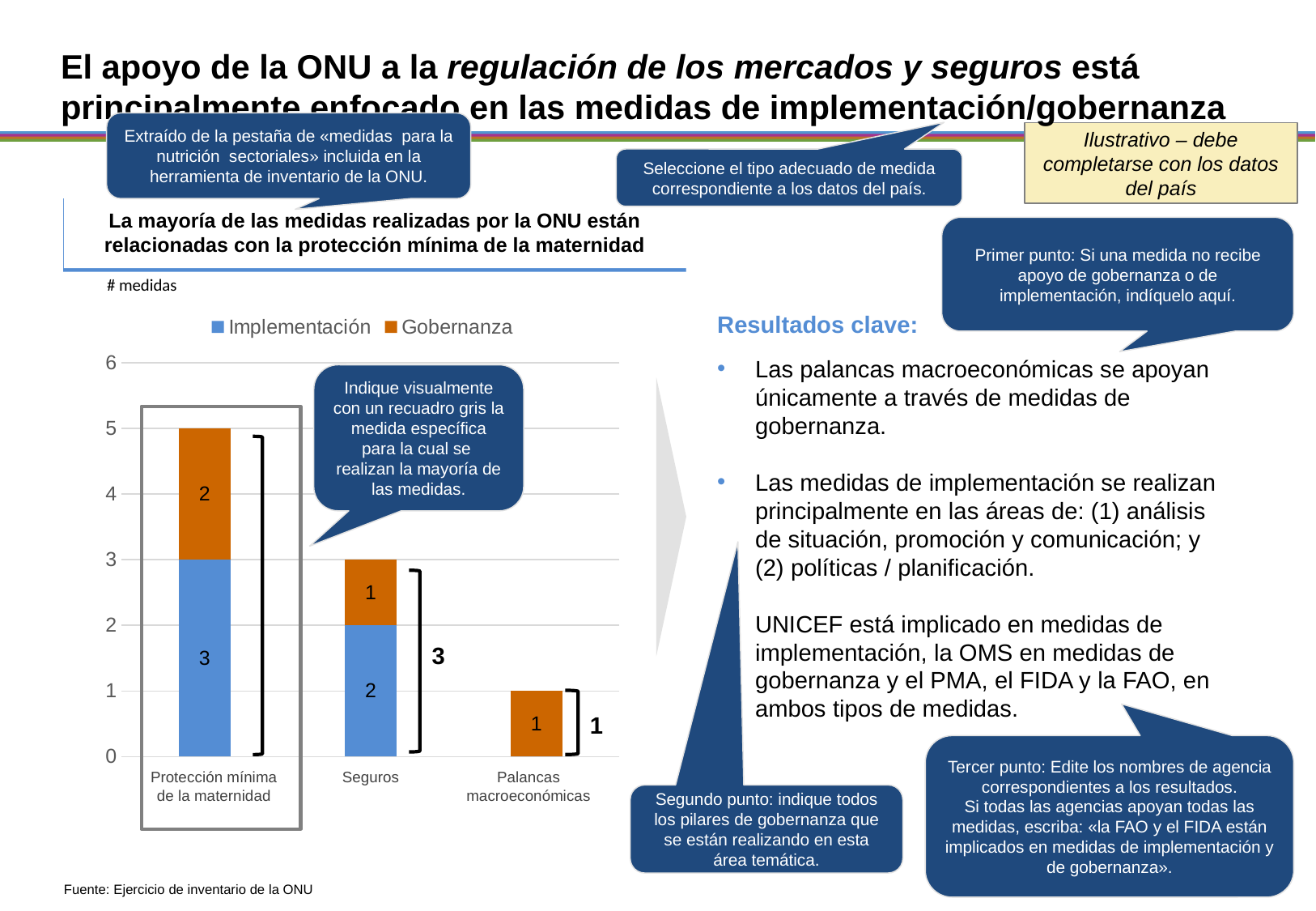
What is the total of the stacked bar for Protección mínima de la maternidad? 5 What is the Gobernanza value for Protección mínima de la maternidad? 2 How many categories are shown on the x axis of the chart? 3 What is the Gobernanza value for Palancas macroeconómicas? 1 What is the difference between the Implementación values for Protección mínima de la maternidad and Seguros? 1 Which category has the highest total number of measures? Protección mínima de la maternidad What is the total of the stacked bar for Seguros? 3 What kind of chart is shown on the slide? Stacked bar chart What is the Implementación value for Seguros? 2 Which category has the lowest total number of measures? Palancas macroeconómicas What is the Implementación value for Protección mínima de la maternidad? 3 How many series does the chart legend list? 2